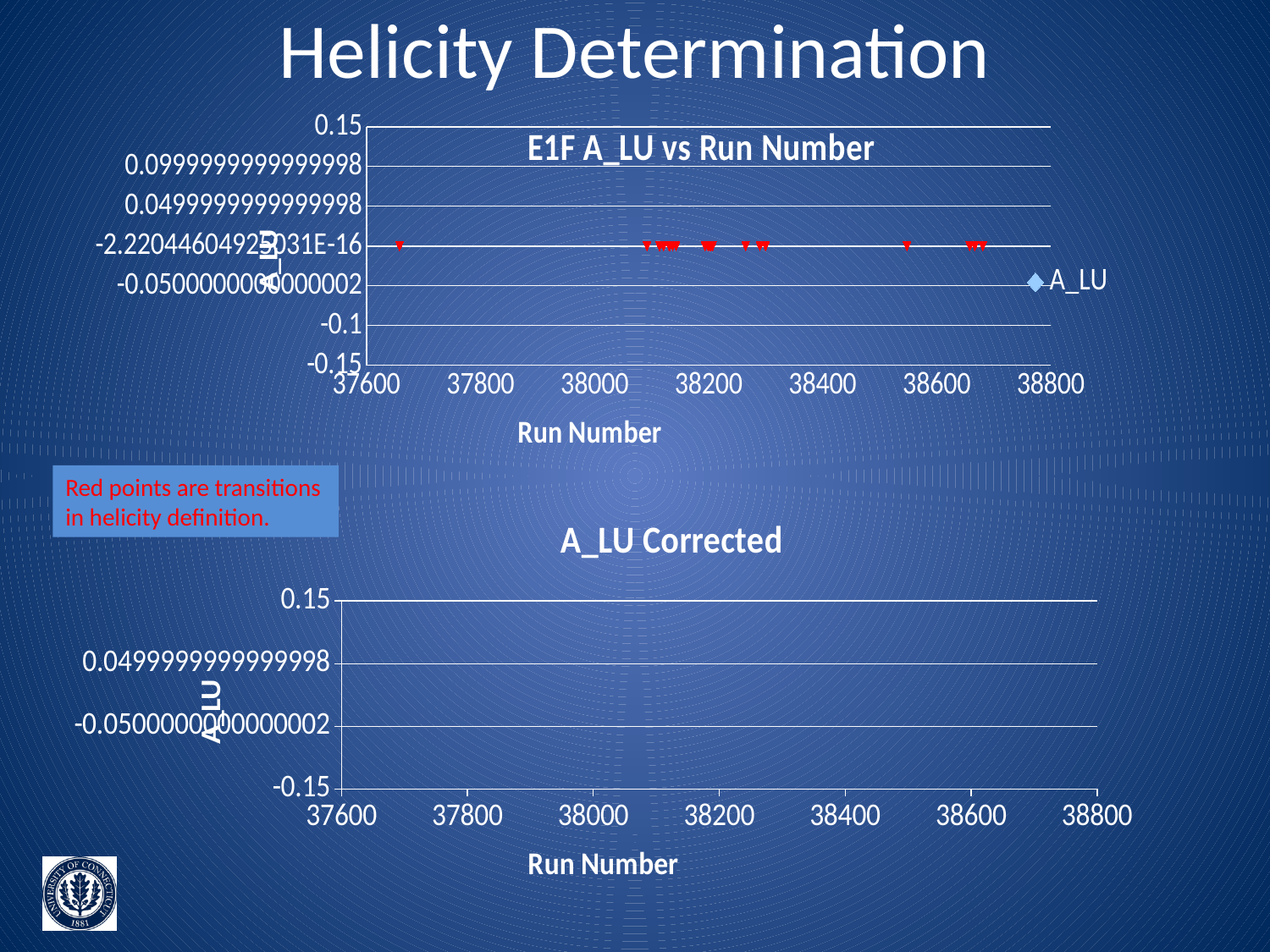
In the top chart, E1F A_LU vs Run Number, what is the name of the series in the legend? A_LU What is the title of the top chart? E1F A_LU vs Run Number In the top chart, E1F A_LU vs Run Number, what is the label of the x axis? Run Number In the top chart, E1F A_LU vs Run Number, are the plotted red points greater or less than 0.05? less In the top chart, E1F A_LU vs Run Number, what kind of chart is shown? Scatter chart In the top chart, E1F A_LU vs Run Number, how many series does the legend list? 1